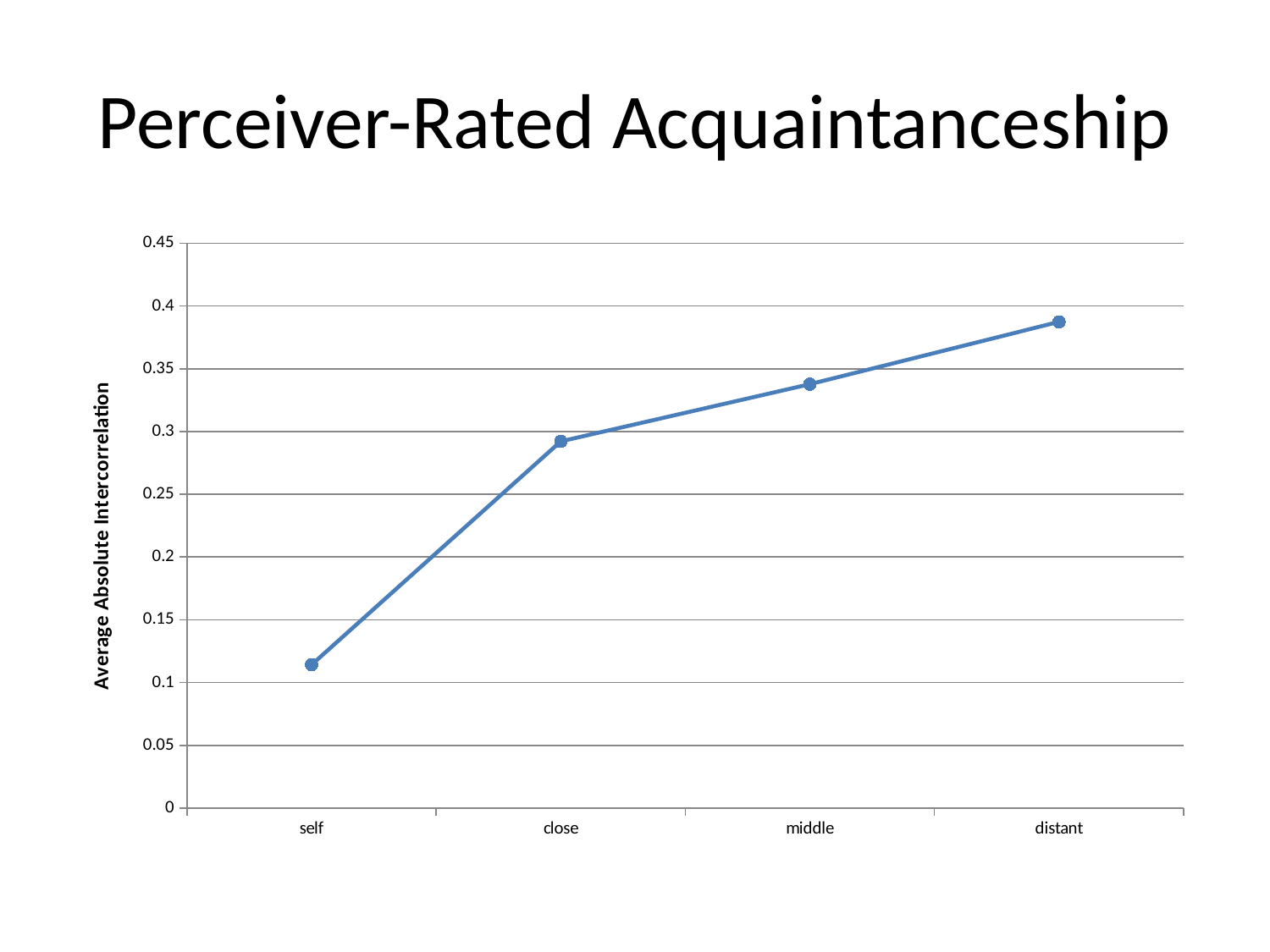
Do the values rise or fall from self to distant along the x axis? rise What kind of chart is shown on the slide? line chart Which category has the highest average absolute intercorrelation? distant Which category has the lowest average absolute intercorrelation? self Which is larger, the value for close or the value for self? close How many categories are plotted along the x axis? 4 Is the value for distant greater or less than 0.4? less What is the title of the slide? Perceiver-Rated Acquaintanceship Is the value for middle greater or less than 0.3? greater Is the value for self greater or less than 0.15? less What is the label of the y axis? Average Absolute Intercorrelation